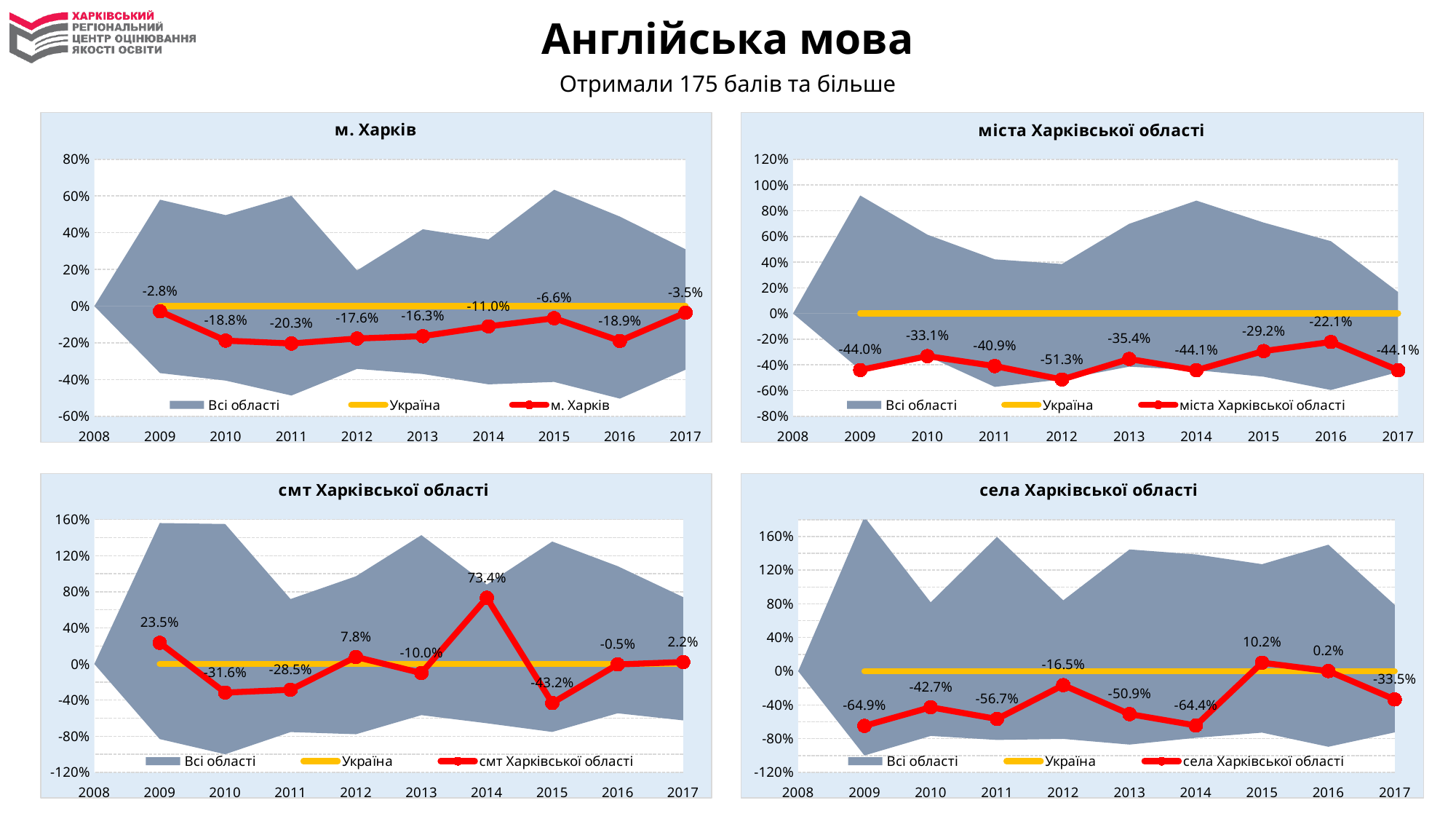
In the chart titled "м. Харків", how many years have a labelled data point on the red line? 9 In the chart titled "міста Харківської області", which is larger: the red line value for 2012 or for 2015? 2015 What kind of chart is the chart titled "смт Харківської області"? Line chart with a shaded area In the chart titled "м. Харків", what colour is the line labelled "Україна" in the legend? Yellow In the chart titled "села Харківської області", how many series does the legend list? 3 In the chart titled "смт Харківської області", which year has the highest value on the red line? 2014 In the chart titled "міста Харківської області", what is the value of the red line for 2016? -22.1% In the chart titled "села Харківської області", which year has the lowest value on the red line? 2009 In the chart titled "м. Харків", what is the difference between the red line values for 2009 and 2010? 16.0 percentage points In the chart titled "смт Харківської області", what is the value of the red line for 2014? 73.4% In the chart titled "села Харківської області", what is the value of the red line for 2015? 10.2% In the chart titled "м. Харків", what is the value of the red line for 2011? -20.3%